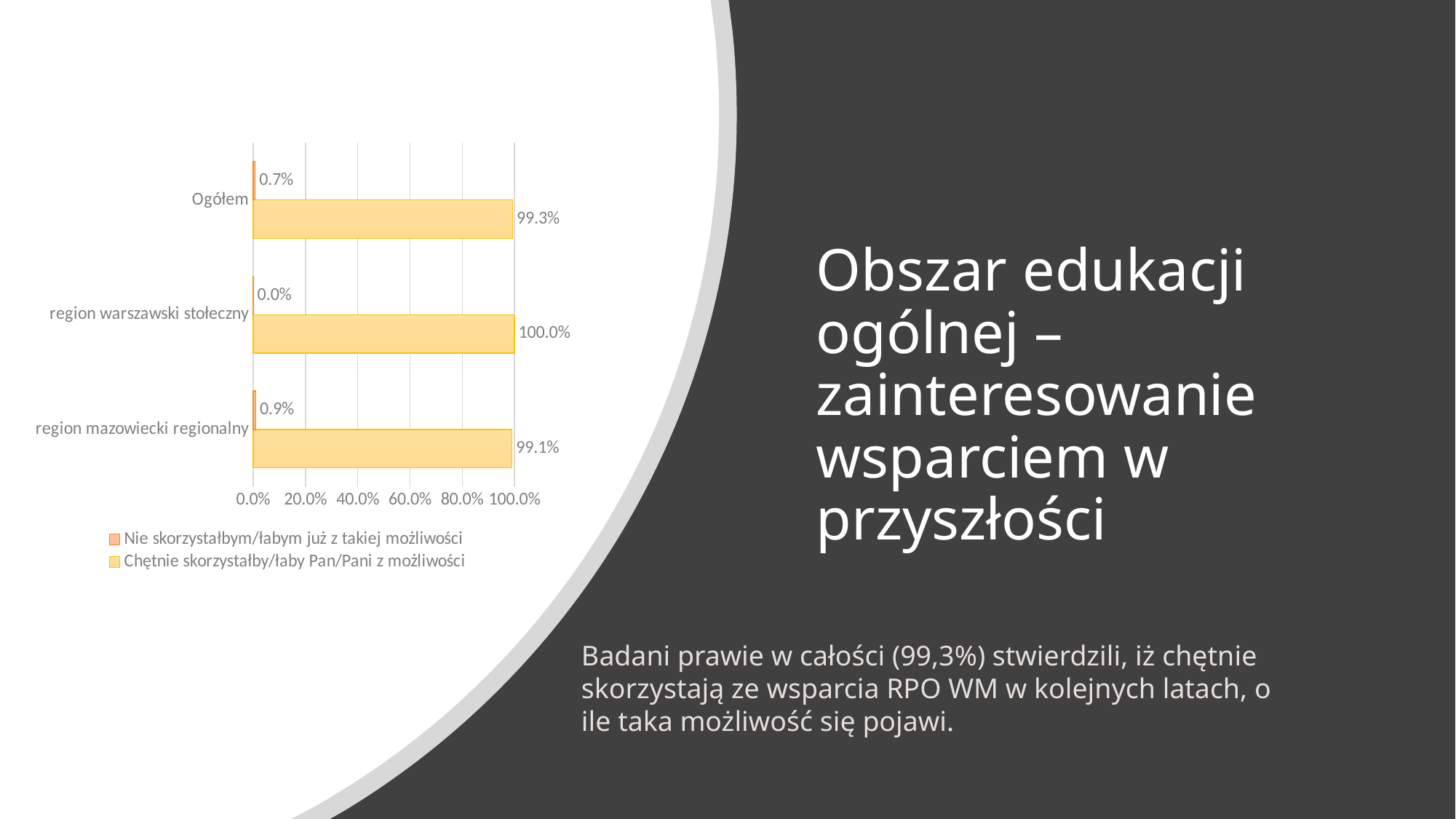
Which category has the lowest value for "Nie skorzystałbym/łabym już z takiej możliwości"? region warszawski stołeczny What is the value of "Nie skorzystałbym/łabym już z takiej możliwości" for region mazowiecki regionalny? 0.9% What is the highest tick value shown on the horizontal axis? 100.0% What is the value of "Nie skorzystałbym/łabym już z takiej możliwości" for region warszawski stołeczny? 0.0% What is the value of "Chętnie skorzystałby/łaby Pan/Pani z możliwości" for Ogółem? 99.3% How many series does the legend list? 2 Which category has the highest value for "Chętnie skorzystałby/łaby Pan/Pani z możliwości"? region warszawski stołeczny What is the difference between the "Chętnie skorzystałby/łaby Pan/Pani z możliwości" values for region warszawski stołeczny and region mazowiecki regionalny? 0.9% Which is larger for Ogółem: "Nie skorzystałbym/łabym już z takiej możliwości" or "Chętnie skorzystałby/łaby Pan/Pani z możliwości"? Chętnie skorzystałby/łaby Pan/Pani z możliwości How many categories are shown on the chart? 3 What kind of chart is shown on the slide? bar chart What is the value of "Chętnie skorzystałby/łaby Pan/Pani z możliwości" for region warszawski stołeczny? 100.0%